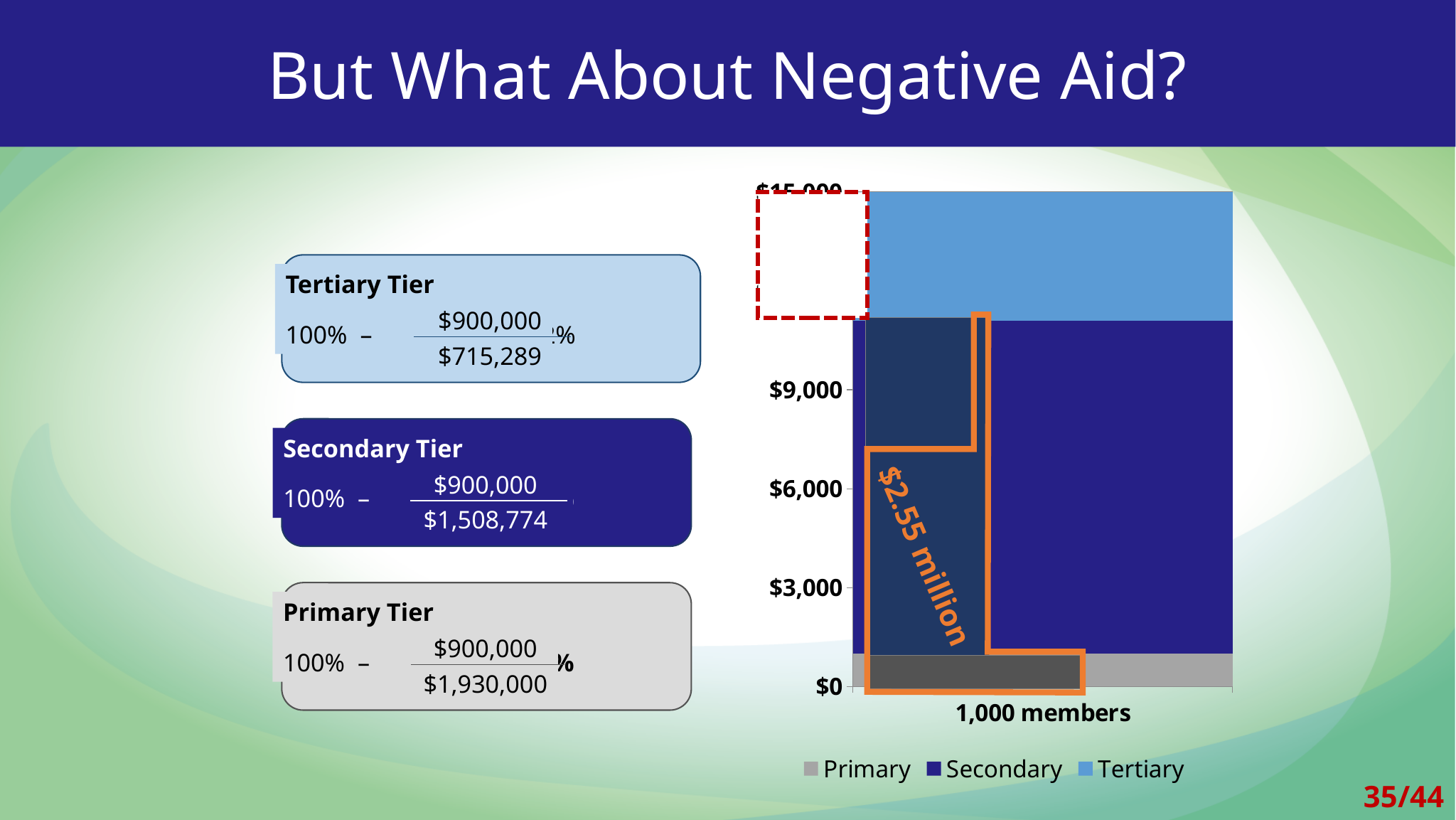
Is the value of the Primary segment greater or less than $3,000? less What are the series names listed in the chart legend? Primary, Secondary, Tertiary What kind of chart is shown on the right of the slide? stacked bar chart What is the category label on the x axis of the chart? 1,000 members Is the total height of the stacked bar greater or less than $9,000? greater Which series has the largest segment in the stacked bar? Secondary How many series does the chart legend list? 3 Which series has the smallest segment in the stacked bar? Primary Is the value of the Secondary segment greater or less than $6,000? greater Is the Secondary segment larger or smaller than the Tertiary segment? larger How many categories are plotted on the x axis of the chart? 1 Is the Tertiary segment larger or smaller than the Primary segment? larger